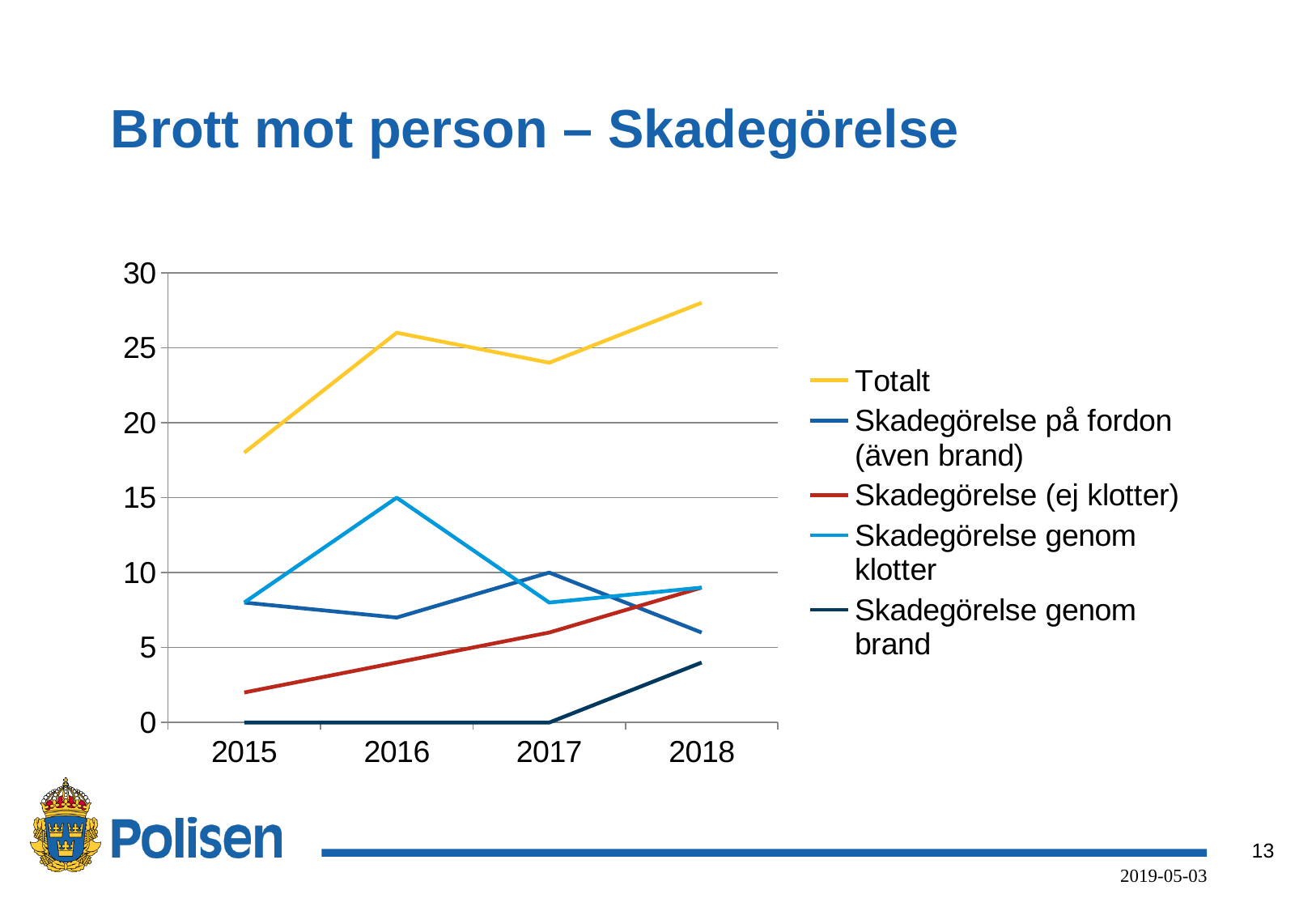
How many series does the legend list? 5 In which year is the Totalt series highest? 2018 In which year is the Totalt series lowest? 2015 How many years are shown on the x axis? 4 What kind of chart is shown on the slide? line chart In 2016, which is larger: Skadegörelse genom klotter or Skadegörelse på fordon (även brand)? Skadegörelse genom klotter What is the value for Skadegörelse genom klotter in 2016? 15 What is the value for Skadegörelse genom brand in 2015? 0 Is the value for Skadegörelse (ej klotter) in 2015 greater or less than 5? less Does the Skadegörelse (ej klotter) series rise or fall from 2015 to 2018? rise What is the value for Skadegörelse på fordon (även brand) in 2017? 10 Is the value for Totalt in 2018 greater or less than 25? greater